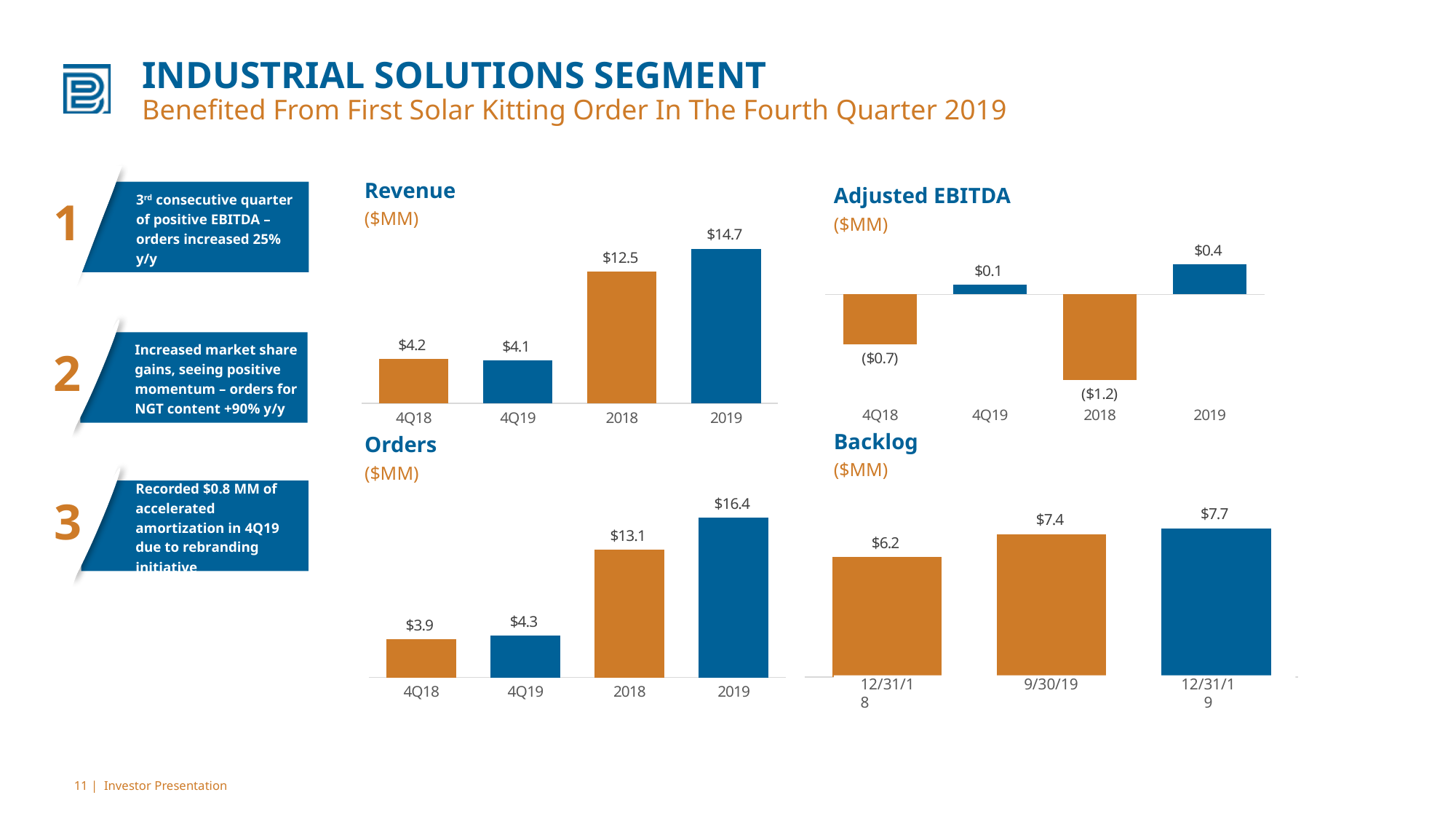
In the Orders chart, what is the value for 4Q19? $4.3 In the Adjusted EBITDA chart, which category has the highest value? 2019 In the Adjusted EBITDA chart, how many categories are shown? 4 What kind of chart is the Backlog chart? bar chart In the Revenue chart, what is the difference between the 2019 and 2018 values? $2.2 In the Orders chart, which is larger, the value for 4Q18 or the value for 4Q19? 4Q19 In the Backlog chart, what is the value for 9/30/19? $7.4 In the Revenue chart, which category has the lowest value? 4Q19 In the Adjusted EBITDA chart, what is the value for 2018? ($1.2) In the Revenue chart, what is the value for 2019? $14.7 In the Orders chart, what is the difference between the 2019 and 2018 values? $3.3 In the Backlog chart, do the values rise or fall from left to right? rise